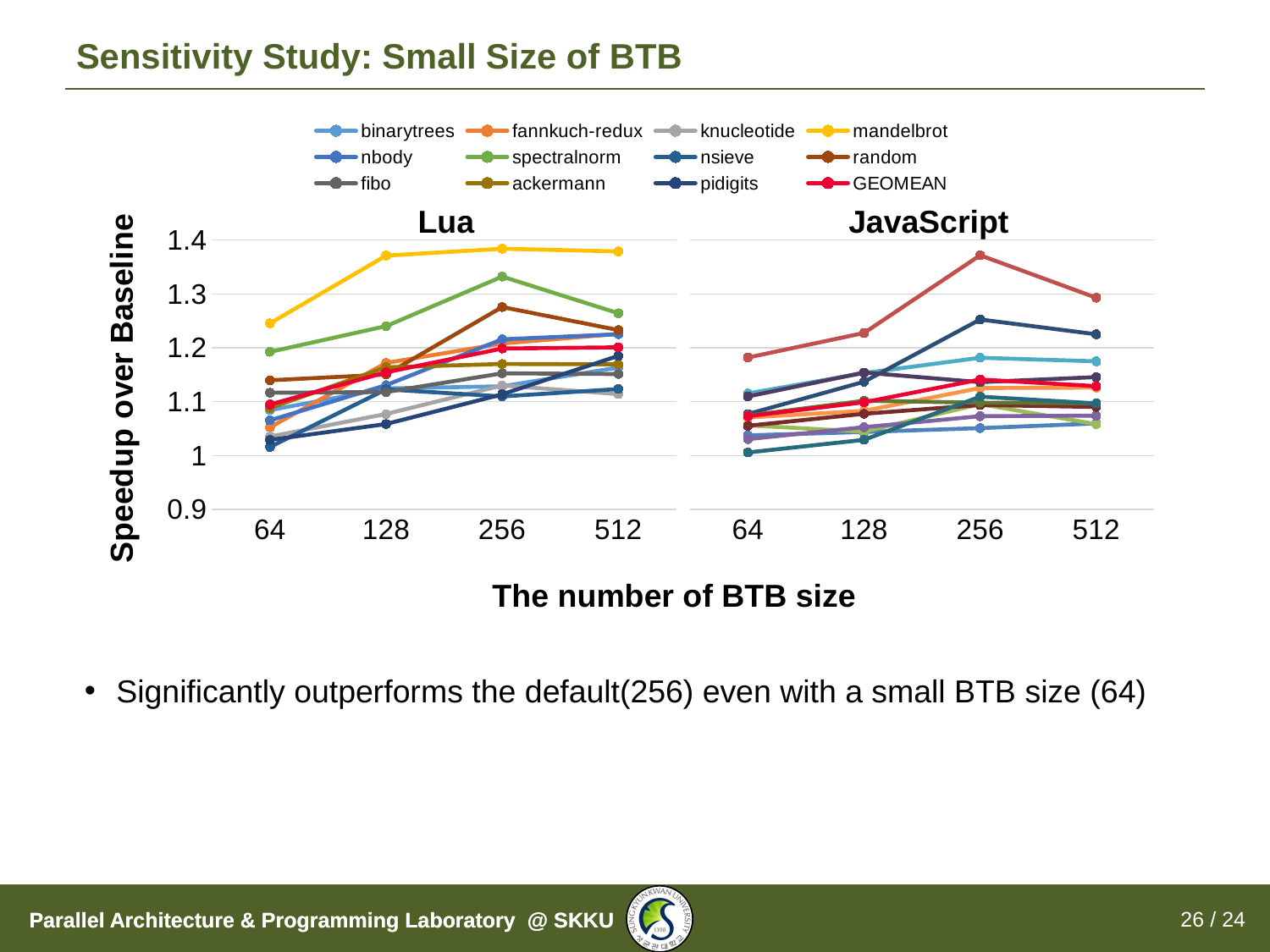
In the Lua chart, which is larger at BTB size 256, mandelbrot or spectralnorm? mandelbrot In the Lua chart, does the mandelbrot line rise or fall from BTB size 64 to 256? rises In the JavaScript chart, is the highest plotted value at BTB size 256 greater or less than 1.3? greater In the Lua chart, is the value for mandelbrot at BTB size 64 greater or less than 1.2? greater What is the title of the x axis shared by the two charts? The number of BTB size In the Lua chart, which series has the highest value at BTB size 512? mandelbrot What kind of chart is used on this slide? line chart In the Lua chart, how many BTB sizes are plotted along the x axis? 4 In the Lua chart, is the value for pidigits at BTB size 64 greater or less than 1.1? less How many series does the legend list? 12